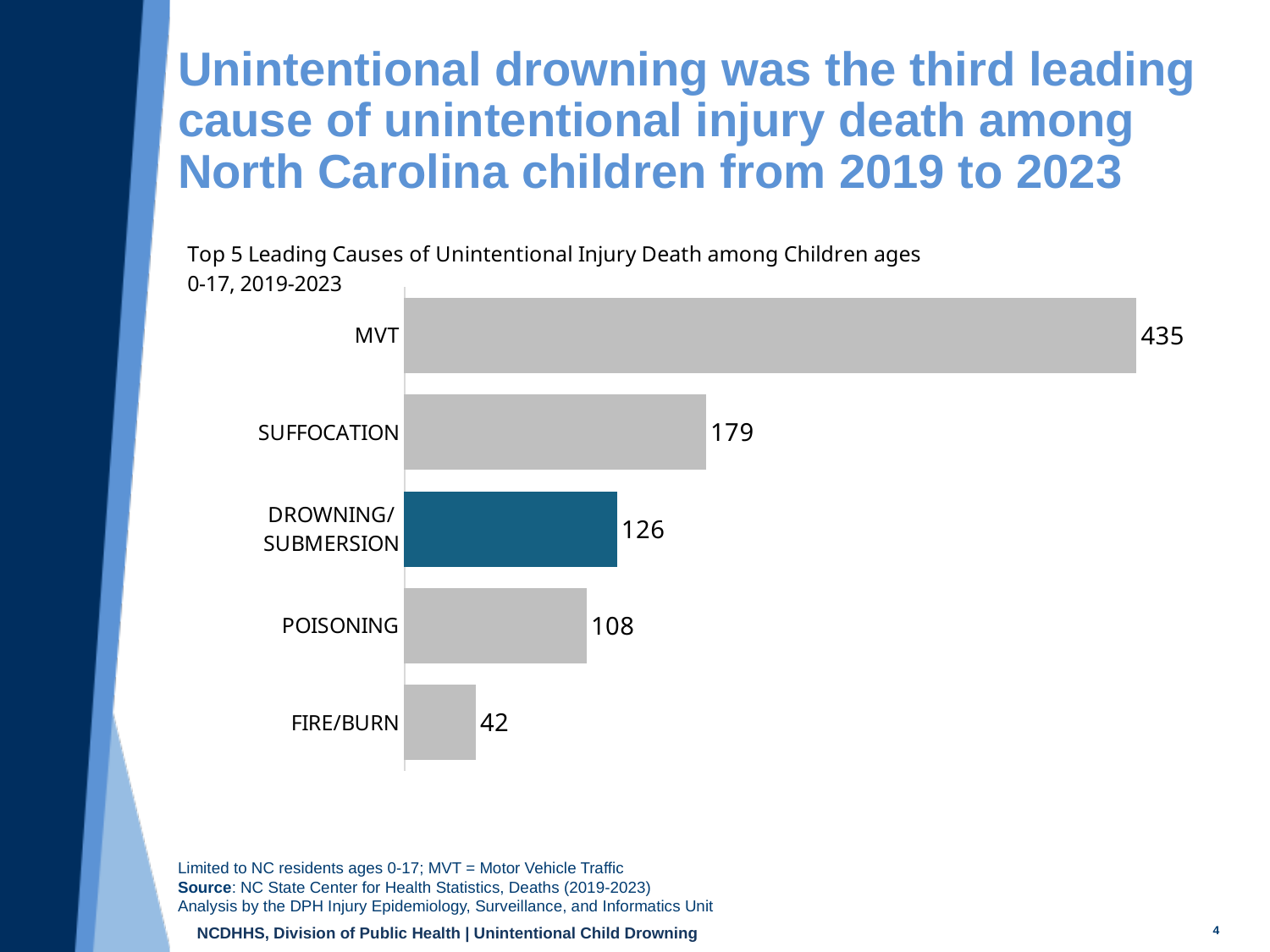
Which cause has the lowest value? FIRE/BURN What is the title of the chart? Top 5 Leading Causes of Unintentional Injury Death among Children ages 0-17, 2019-2023 What is the difference between the values for DROWNING/SUBMERSION and POISONING? 18 What is the difference between the values for MVT and SUFFOCATION? 256 What is the value for DROWNING/SUBMERSION? 126 What is the value for FIRE/BURN? 42 Which is larger, the value for SUFFOCATION or the value for POISONING? SUFFOCATION Which cause has the highest value? MVT What is the value for MVT? 435 What kind of chart is shown on the slide? Bar chart How many causes are shown in the chart? 5 Which bar is coloured differently (blue) from the others? DROWNING/SUBMERSION